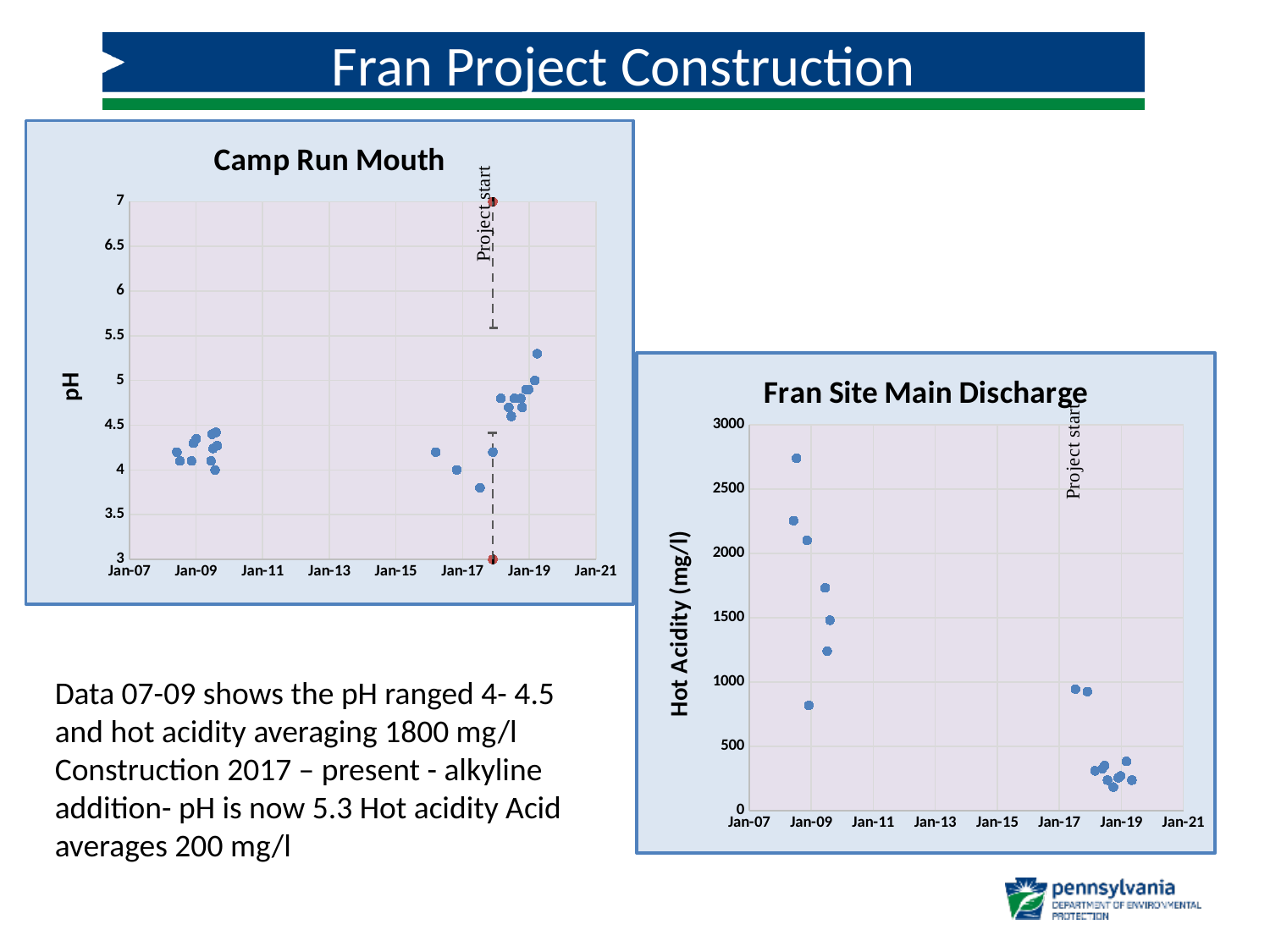
On the Fran Site Main Discharge chart, is the highest hot acidity value plotted greater or less than 2500? greater On the Fran Site Main Discharge chart, what is the y-axis title? Hot Acidity (mg/l) What kind of chart is the Camp Run Mouth chart? scatter chart On the Camp Run Mouth chart, do the pH values rise or fall from 2017 to 2019? rise On the Fran Site Main Discharge chart, do the hot acidity values rise or fall from the 2008 data to the 2019 data? fall On the Camp Run Mouth chart, is the highest pH value plotted greater or less than 5? greater On the Fran Site Main Discharge chart, are the hot acidity values plotted around Jan-19 greater or less than 500? less On the Camp Run Mouth chart, what does the dashed vertical line mark? Project start What kind of chart is the Fran Site Main Discharge chart? scatter chart